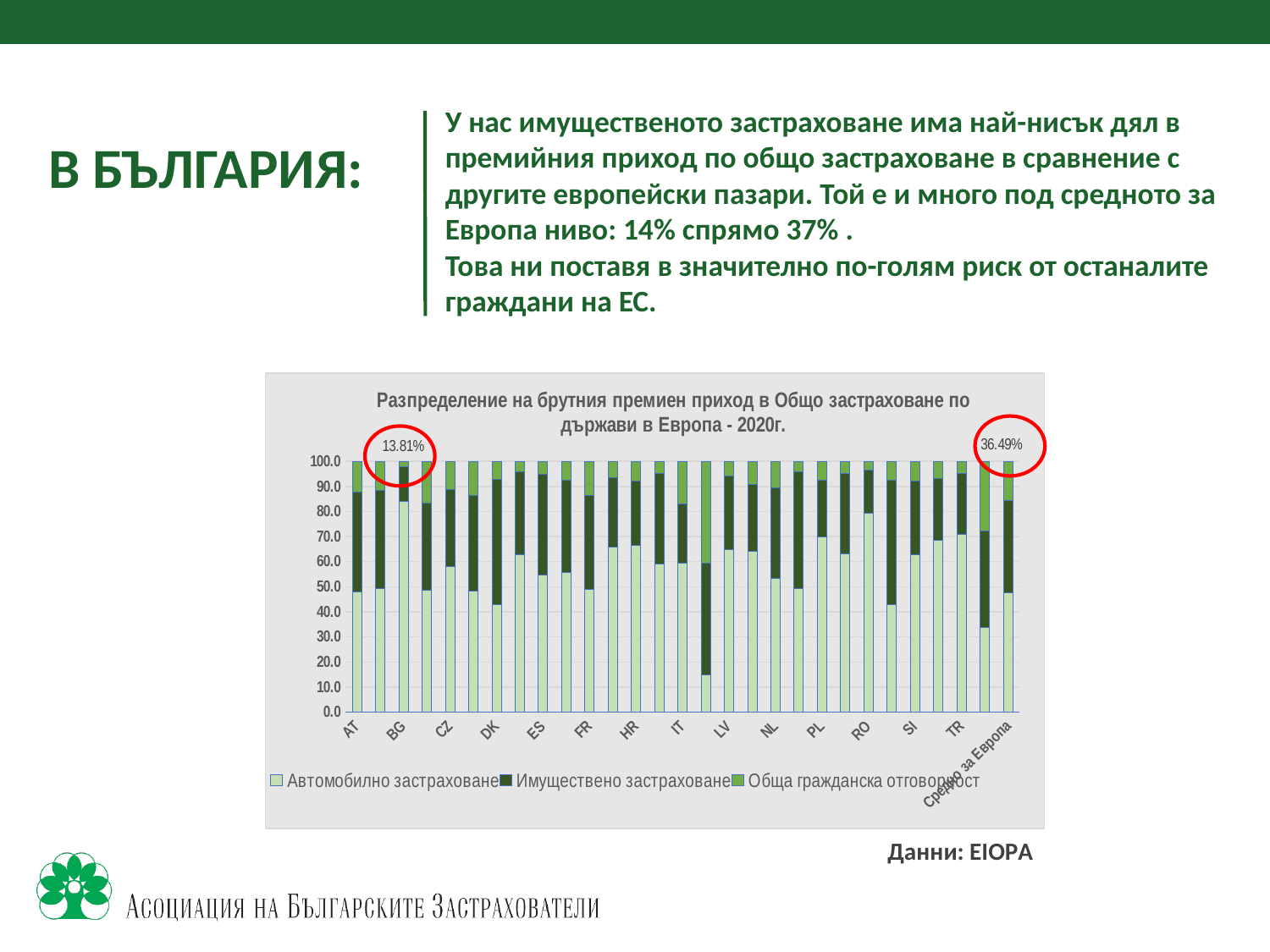
What is the total height of the stacked bar for BG, as read from the y axis? 100.0 What kind of chart is shown on the slide? bar chart Is the Автомобилно застраховане value for DK greater or less than 50? less What is the difference between the annotated value for Средно за Европа (36.49%) and the annotated value for BG (13.81%)? 22.68% Is the Автомобилно застраховане value for BG greater or less than 70? greater What value is annotated above the Средно за Европа bar in the chart? 36.49% What data source is cited below the chart? EIOPA Is the Автомобилно застраховане value for RO greater or less than 70? greater Which has the larger annotated value, BG or Средно за Европа? Средно за Европа How many series does the chart legend list? 3 What value is annotated above the BG bar in the chart? 13.81% What is the title of the chart? Разпределение на брутния премиен приход в Общо застраховане по държави в Европа - 2020г.